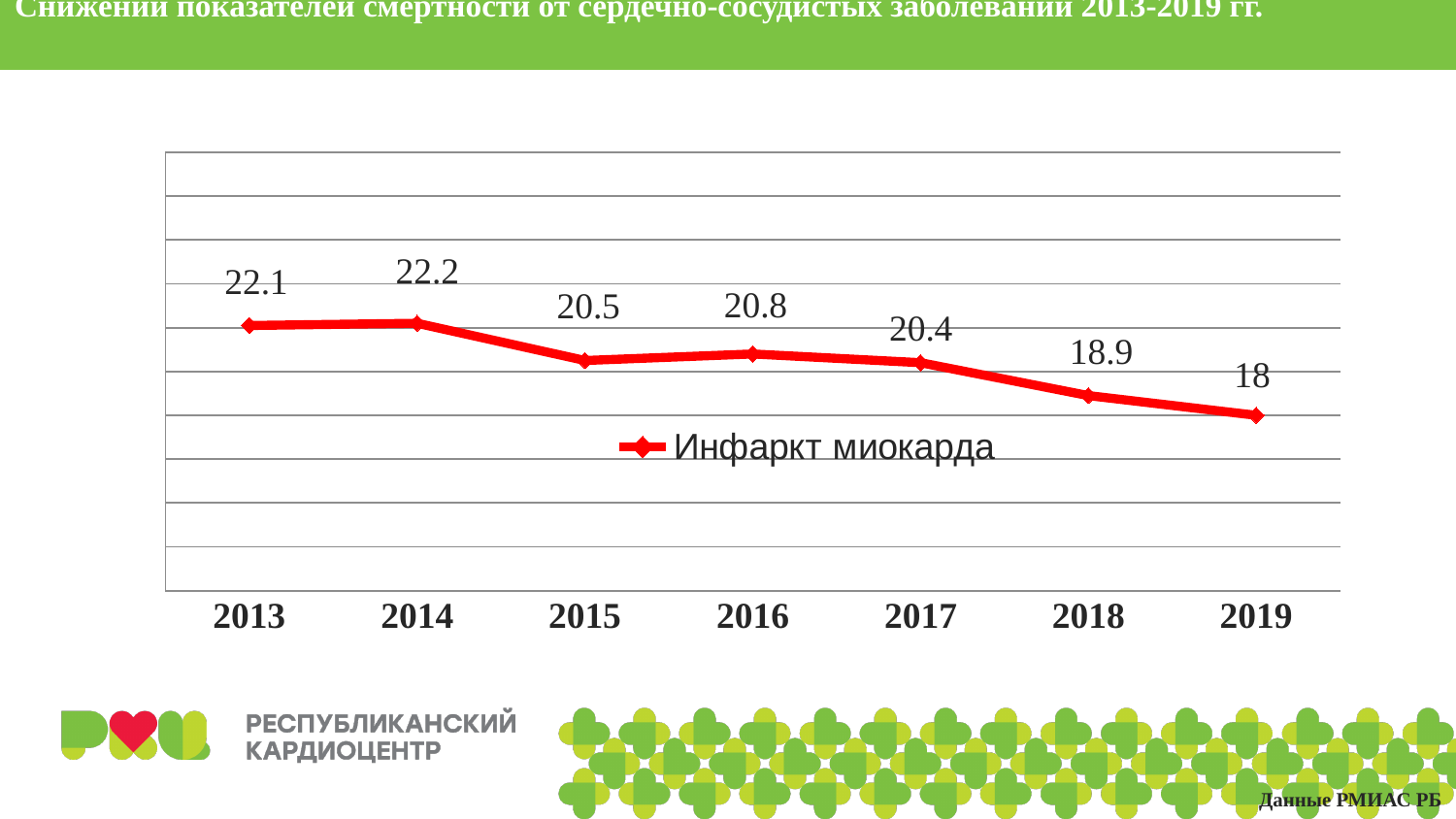
What is the value for 2016? 20.8 How many series does the legend list? 1 What kind of chart is shown? line chart Do the values generally rise or fall from 2013 to 2019? fall Which year has the highest value? 2014 How many years are plotted on the chart? 7 What is the difference between the values for 2015 and 2016? 0.3 Which year has the lowest value? 2019 Which is larger, the value for 2017 or the value for 2018? 2017 What is the difference between the values for 2014 and 2019? 4.2 What is the value for 2013? 22.1 What is the value for 2019? 18